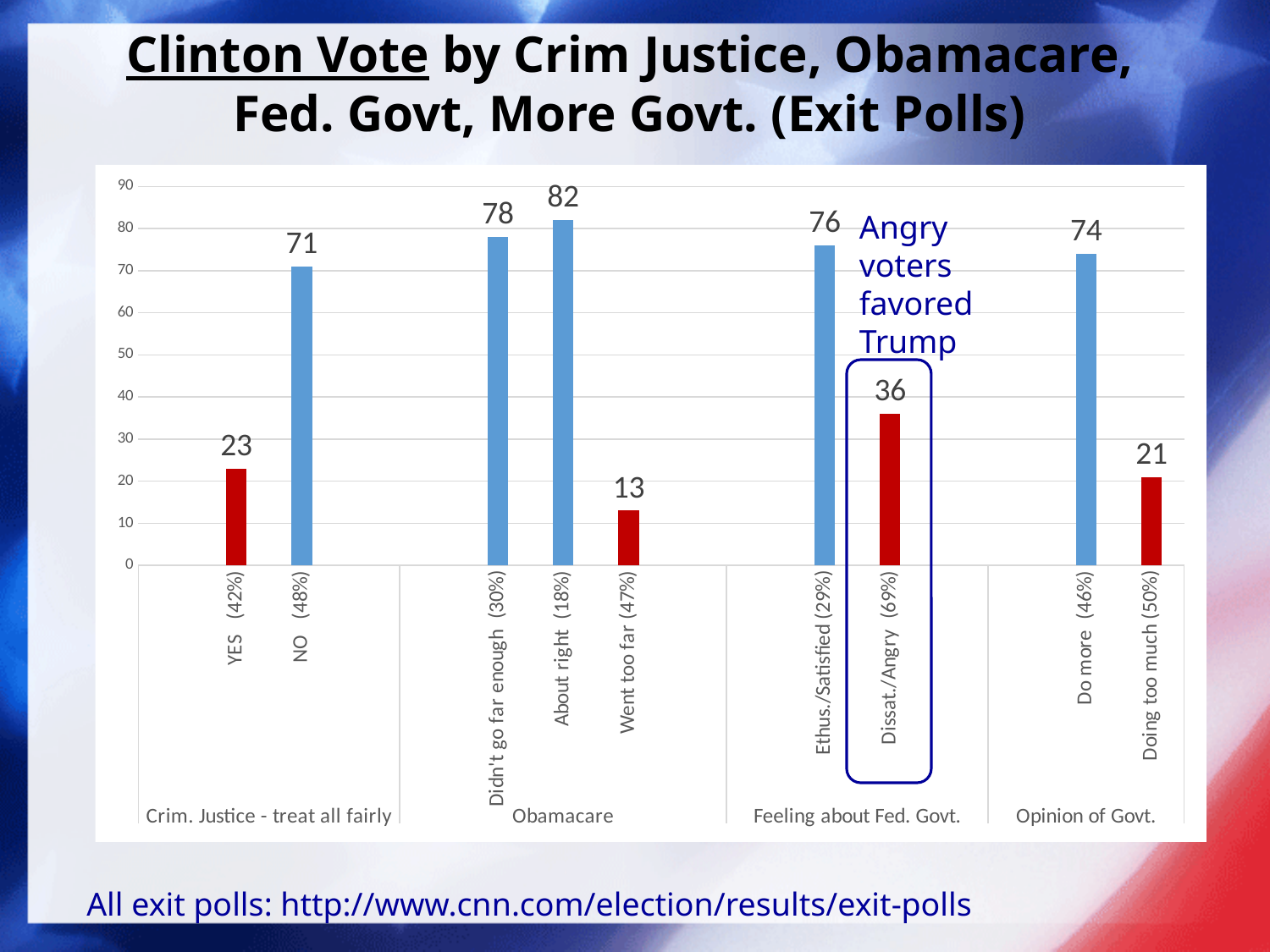
What is the Clinton vote value for 'NO (48%)' under Crim. Justice - treat all fairly? 71 What is the Clinton vote value for 'Dissat./Angry (69%)' under Feeling about Fed. Govt.? 36 What kind of chart is shown on the slide? Bar chart Which category has the lowest Clinton vote value? Went too far (47%) How many bars are plotted in the chart? 9 What is the difference between the Clinton vote values for 'Ethus./Satisfied (29%)' and 'Dissat./Angry (69%)'? 40 What is the Clinton vote value for 'Went too far (47%)' under Obamacare? 13 Which has a larger Clinton vote value: 'YES (42%)' or 'Doing too much (50%)'? YES (42%) Which category has the highest Clinton vote value? About right (18%) What is the Clinton vote value for 'Do more (46%)' under Opinion of Govt.? 74 What is the difference between the Clinton vote values for 'About right (18%)' and 'Didn't go far enough (30%)'? 4 What does the annotation text next to the 'Dissat./Angry' bar say? Angry voters favored Trump